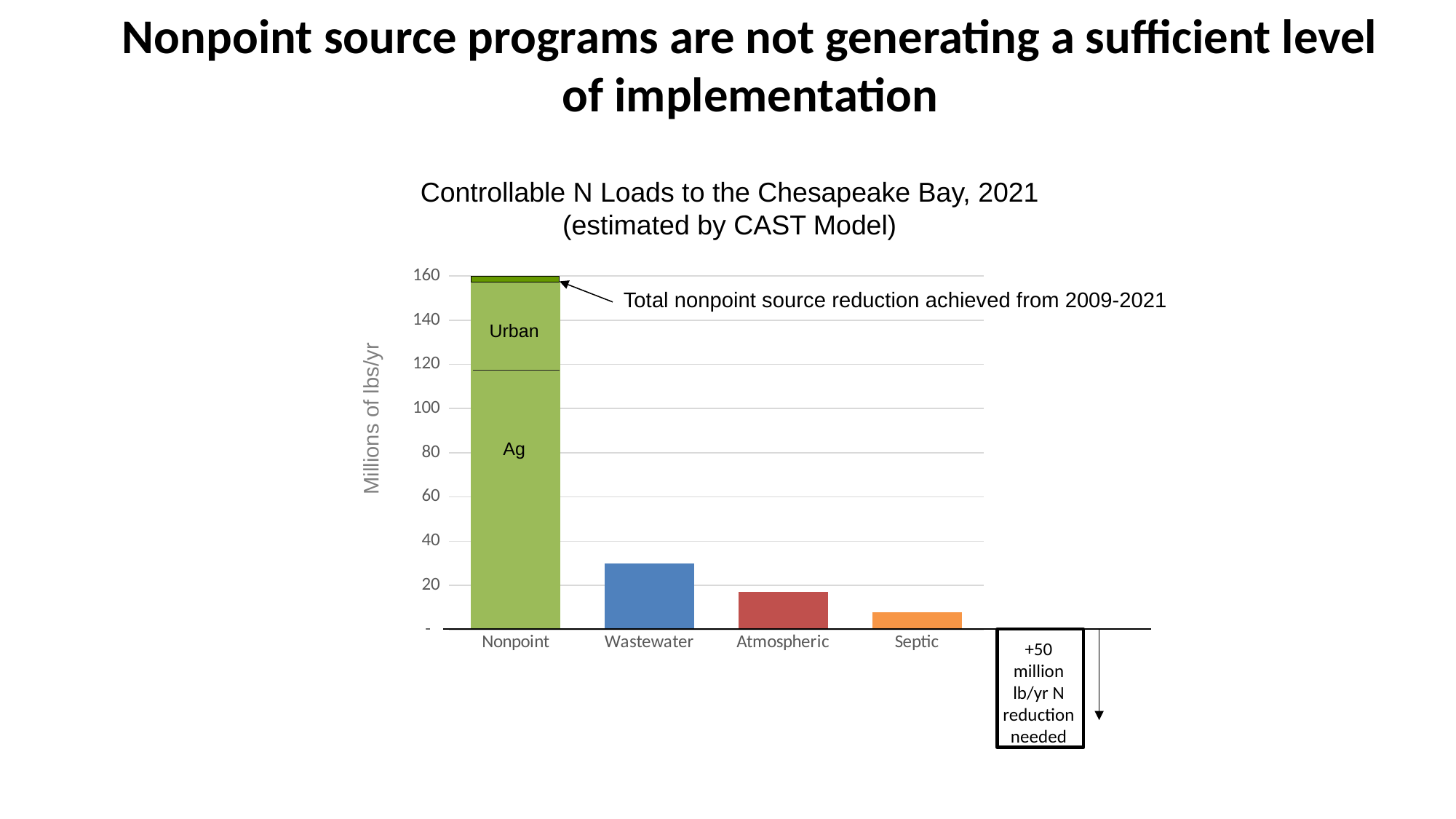
Is the value for Wastewater greater or less than 40? less Is the value for Septic greater or less than 20? less Which category has the lowest controllable N load? Septic How many categories are shown on the x axis of the chart? 4 What is the label on the vertical axis of the chart? Millions of lbs/yr Is the value for Atmospheric greater or less than 20? less What are the two labelled segments of the Nonpoint bar? Ag and Urban What kind of chart is shown on the slide? bar chart Which category has the highest controllable N load? Nonpoint Which is larger, the value for Wastewater or the value for Atmospheric? Wastewater